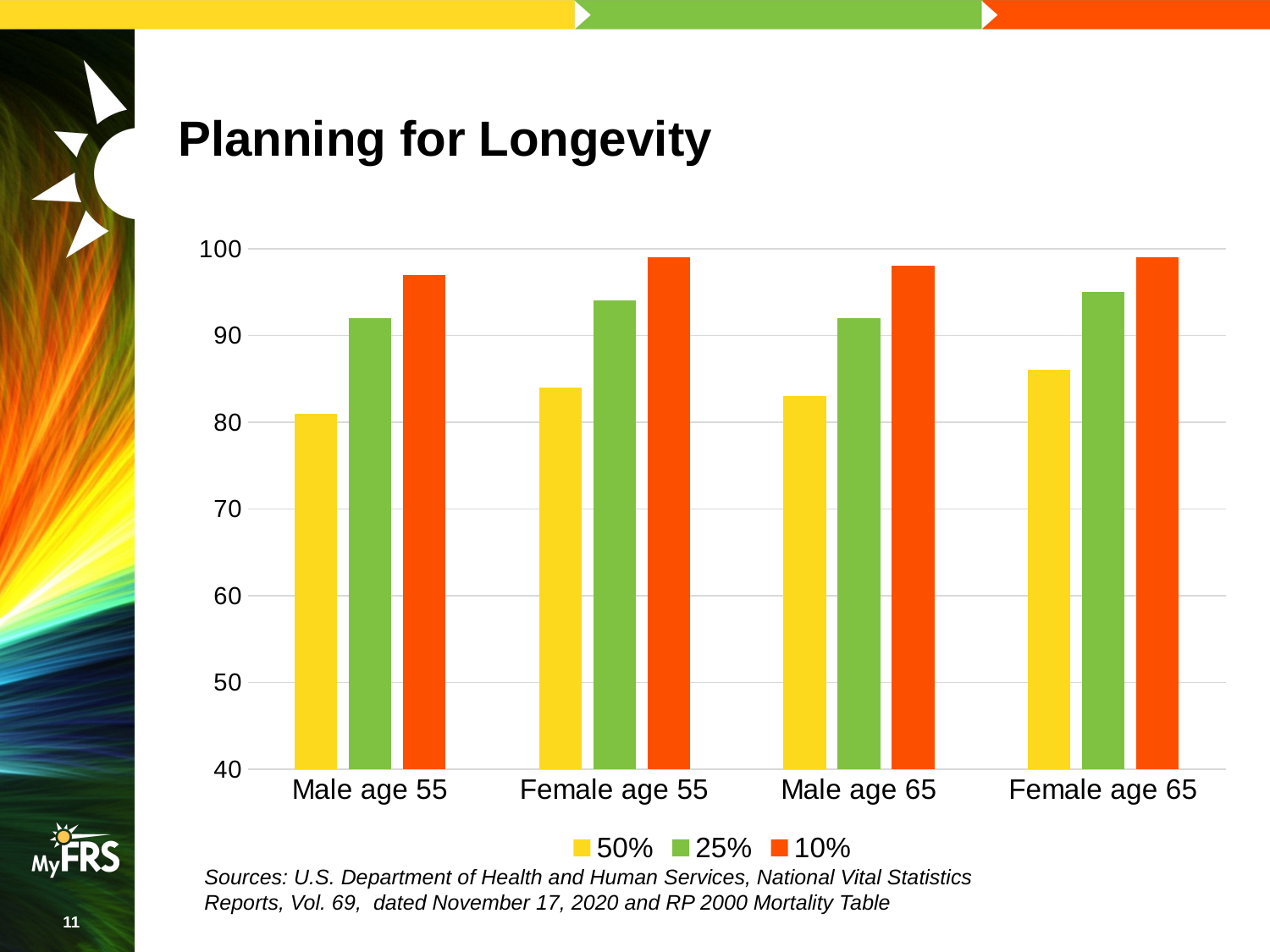
Which colour represents the 10% series in the chart? orange-red What are the three series listed in the chart's legend? 50%, 25%, 10% Is the 50% value for Female age 65 greater or less than 90? less What kind of chart is shown on the slide? bar chart Which is larger, the 50% value for Female age 65 or the 50% value for Male age 65? Female age 65 How many series does the chart's legend list? 3 Which category has the lowest 50% value? Male age 55 Is the 25% value for Male age 65 greater or less than 90? greater How many categories are shown on the x axis of the chart? 4 Within each category, which series has the highest bar? 10%